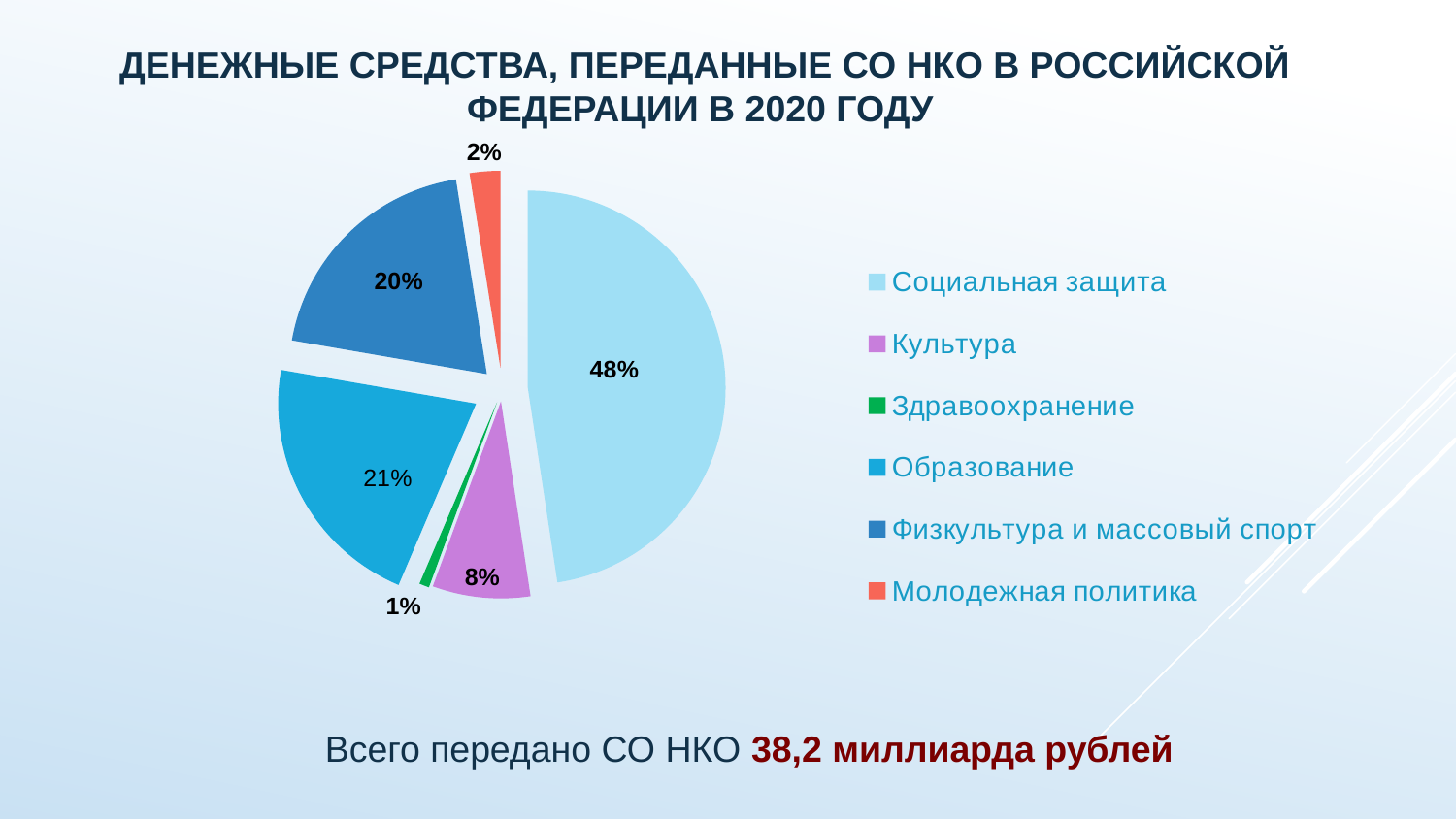
How many categories does the pie chart show? 6 What is the value shown for Молодежная политика? 2% Which category has the smallest share of the pie? Здравоохранение Which is larger, the share for Культура or the share for Физкультура и массовый спорт? Физкультура и массовый спорт Which category has the largest share of the pie? Социальная защита What kind of chart is shown on the slide? Pie chart What total amount transferred to СО НКО is stated below the chart? 38,2 миллиарда рублей What is the difference in percentage points between Социальная защита and Образование? 27 What is the difference in percentage points between Культура and Молодежная политика? 6 What is the value shown for Образование? 21% What is the value shown for Культура? 8% What share of the pie does Социальная защита account for? 48%